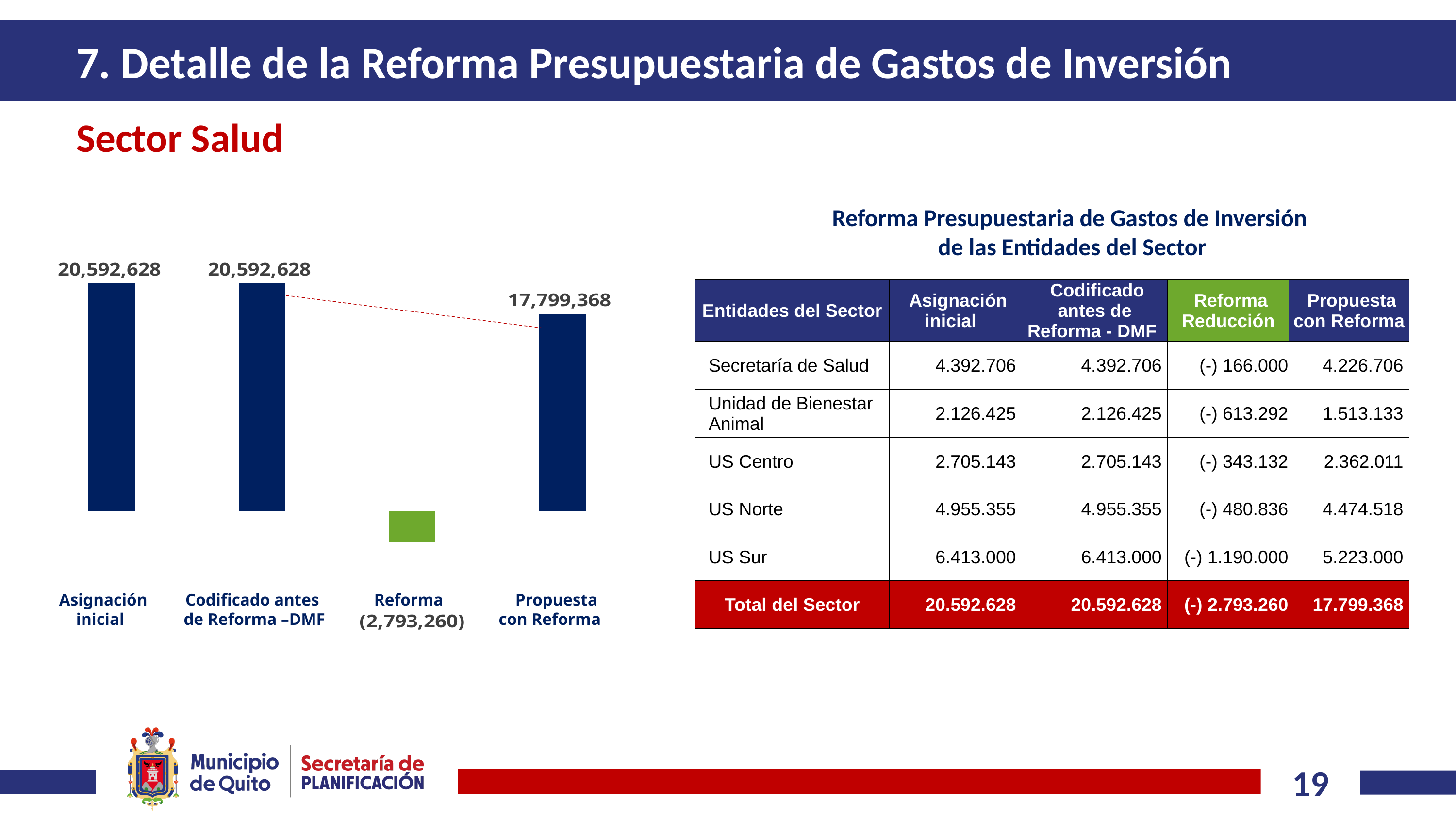
Which sector does the chart on the slide refer to? Sector Salud Which category in the chart has the lowest bar? Reforma Do the values in the chart rise or fall from 'Codificado antes de Reforma –DMF' to 'Propuesta con Reforma'? Fall What kind of chart is shown on the slide? Bar chart Which is larger in the chart, 'Asignación inicial' or 'Propuesta con Reforma'? Asignación inicial What colour is the 'Reforma' bar in the chart? Green What value is shown for the 'Reforma' bar in the chart? (2,793,260) What is the value of the 'Asignación inicial' bar in the chart? 20,592,628 What is the difference between the 'Codificado antes de Reforma –DMF' bar and the 'Propuesta con Reforma' bar? 2,793,260 What is the value of the 'Propuesta con Reforma' bar in the chart? 17,799,368 What is the value of the 'Codificado antes de Reforma –DMF' bar in the chart? 20,592,628 How many categories are shown on the x axis of the chart? 4